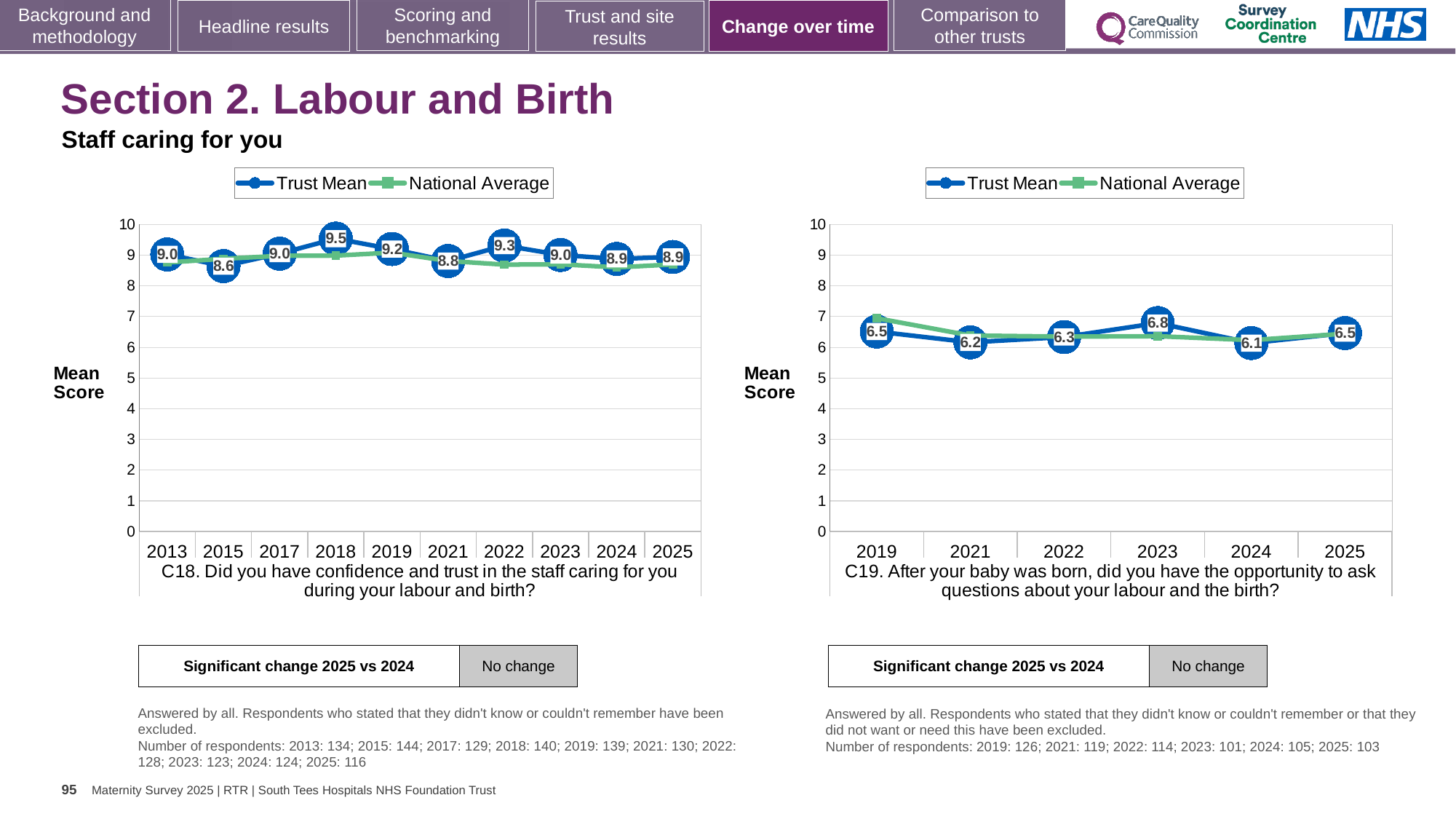
In the C18 chart (left), what is the difference between the Trust Mean scores for 2018 and 2015? 0.9 In the C19 chart (right), is the Trust Mean score for 2022 higher or lower than for 2023? lower How many series does the legend of the C19 chart (right) list? 2 In the C19 chart (right), what is the Trust Mean score for 2023? 6.8 In the C18 chart (left), which year has the highest Trust Mean score? 2018 What type of chart is the C18 chart (left)? line chart In the C18 chart (left), which year has the lowest Trust Mean score? 2015 In the C18 chart (left), what is the Trust Mean score for 2018? 9.5 In the C19 chart (right), which year has the lowest Trust Mean score? 2024 In the C18 chart (left), what is the Trust Mean score for 2015? 8.6 In the C19 chart (right), is the Trust Mean value for 2025 greater or less than 6? greater In the C18 chart (left), how many years are shown on the x axis? 10